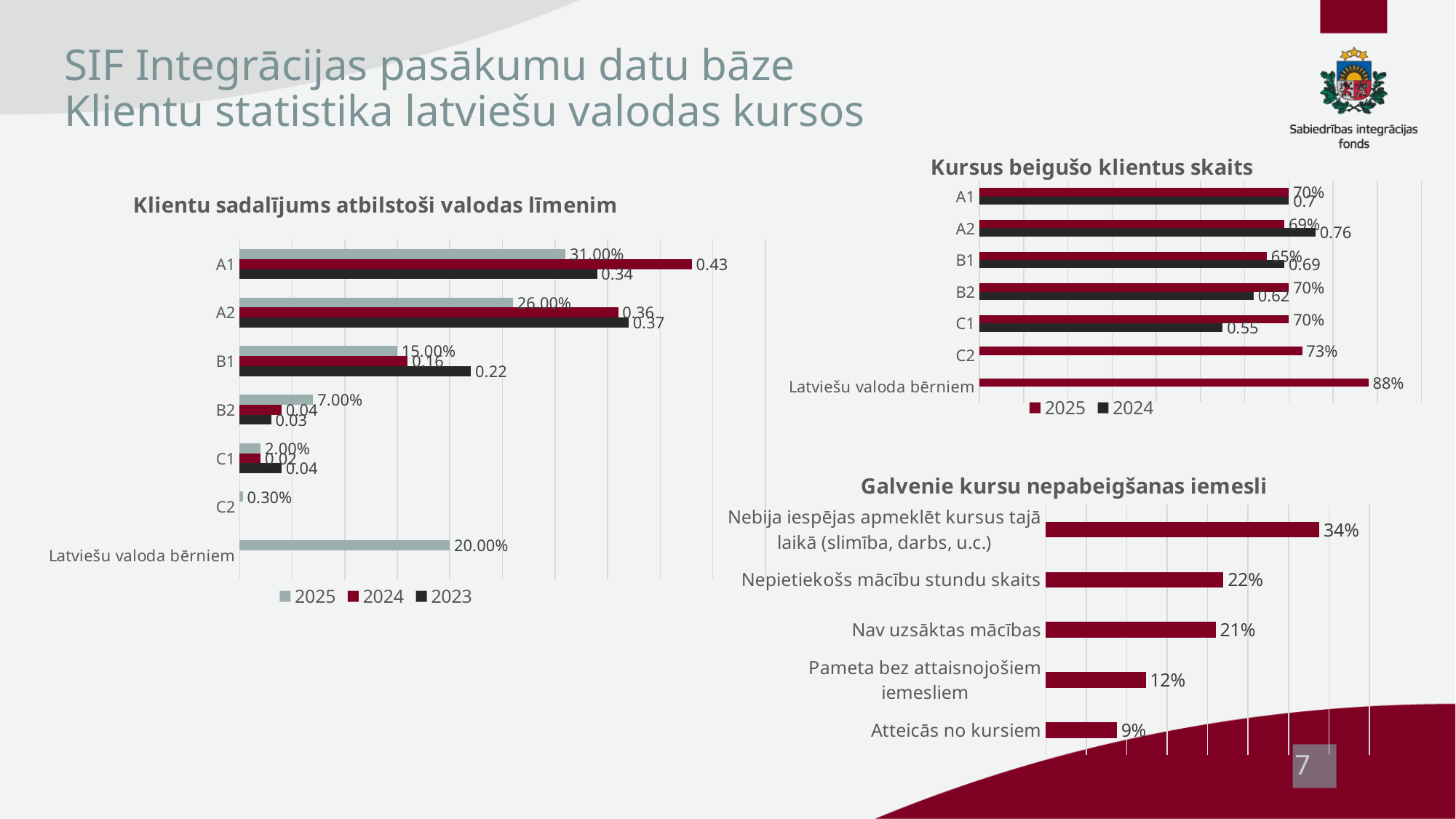
In the chart 'Kursus beigušo klientus skaits', how many categories are shown? 7 In the chart 'Klientu sadalījums atbilstoši valodas līmenim', what is the 2025 value for A1? 31.00% In the chart 'Kursus beigušo klientus skaits', what is the 2024 value for C1? 0.55 In the chart 'Galvenie kursu nepabeigšanas iemesli', what is the value for Nepietiekošs mācību stundu skaits? 22% In the chart 'Klientu sadalījums atbilstoši valodas līmenim', how many series does the legend list? 3 In the chart 'Klientu sadalījums atbilstoši valodas līmenim', what is the 2024 value for A2? 0.36 In the chart 'Klientu sadalījums atbilstoši valodas līmenim', which category has the highest 2025 value? A1 What kind of chart is 'Galvenie kursu nepabeigšanas iemesli'? Bar chart In the chart 'Galvenie kursu nepabeigšanas iemesli', what is the difference between the highest and lowest values? 25% In the chart 'Kursus beigušo klientus skaits', which category has the lowest 2025 value? B1 In the chart 'Kursus beigušo klientus skaits', what is the 2025 value for Latviešu valoda bērniem? 88% In the chart 'Klientu sadalījums atbilstoši valodas līmenim', which is larger for B1: the 2024 value or the 2023 value? 2023